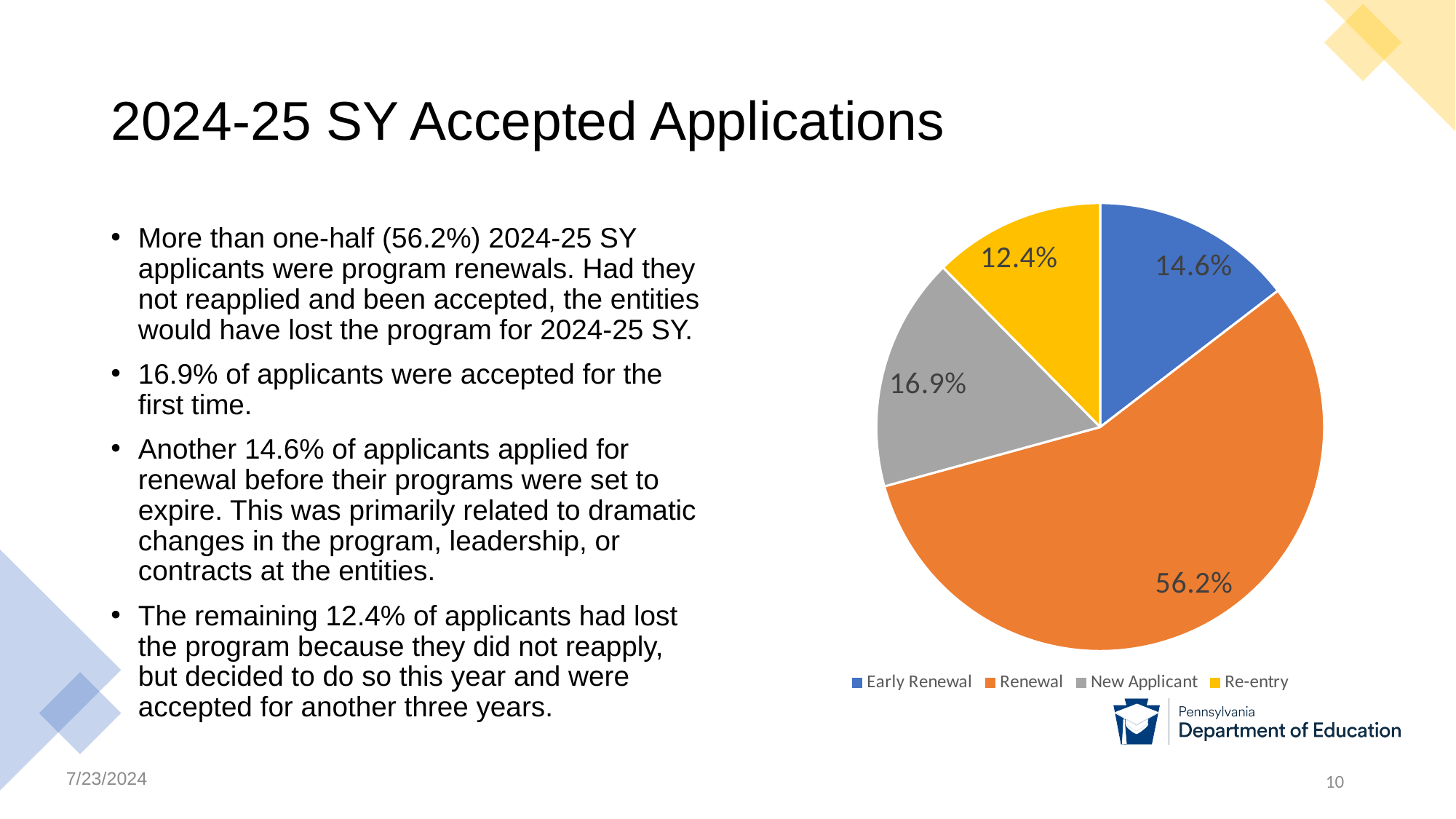
How many slices does the pie chart have? 4 What kind of chart is shown on the slide? pie chart How many entries does the legend list? 4 Which is larger, the New Applicant slice or the Early Renewal slice? New Applicant Which category has the smallest share of the pie? Re-entry What percentage of accepted applications were Renewals? 56.2% What percentage of accepted applications were Re-entry? 12.4% What colour is the Renewal slice? orange What percentage of accepted applications were Early Renewals? 14.6% Which category has the largest share of the pie? Renewal What percentage of accepted applications were New Applicants? 16.9% What is the difference in percentage points between the Renewal and New Applicant slices? 39.3